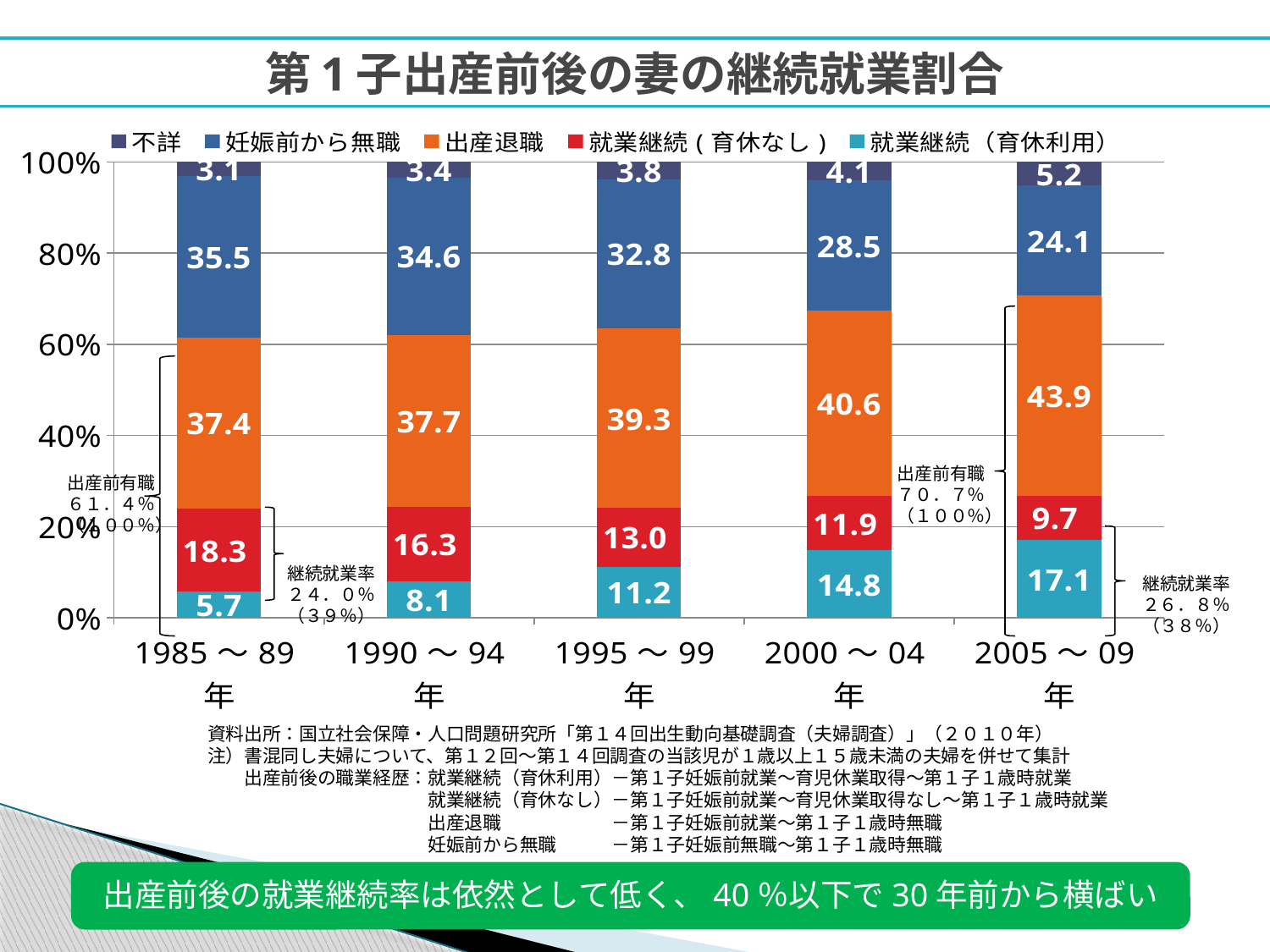
What is the value of 出産退職 for 2005～09年? 43.9 Which is larger: 就業継続(育休なし) for 1990～94年 or 就業継続（育休利用） for 1990～94年? 就業継続(育休なし) How many series does the legend list? 5 What is the value of 就業継続（育休利用） for 1985～89年? 5.7 How many period categories are shown on the x axis? 5 What is the value of 妊娠前から無職 for 2000～04年? 28.5 Which period has the highest value for 就業継続（育休利用）? 2005～09年 Which period has the lowest value for 不詳? 1985～89年 What type of chart is shown on the slide? stacked bar chart Does the value of 就業継続（育休利用） rise or fall from 1985～89年 to 2005～09年? rise What is the difference between the 妊娠前から無職 values for 1985～89年 and 2005～09年? 11.4 What is the value of 就業継続(育休なし) for 1995～99年? 13.0